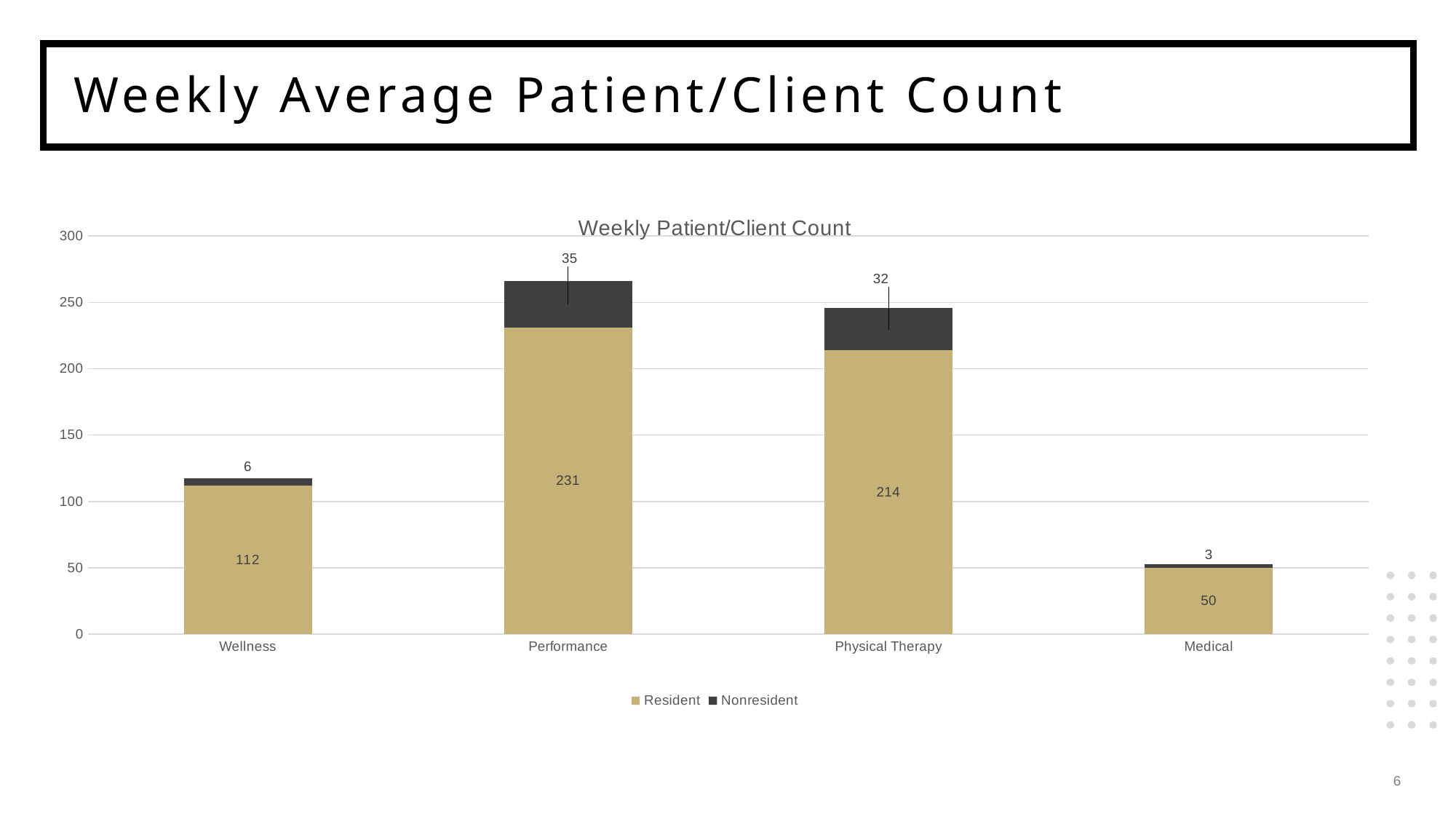
Which category has the highest Resident value? Performance What kind of chart is shown? Stacked bar chart Which category has the lowest Nonresident value? Medical What is the Nonresident value for Wellness? 6 What is the Nonresident value for Physical Therapy? 32 What is the total of the stacked bar for Physical Therapy? 246 How many series does the legend list? 2 What is the Resident value for Medical? 50 What is the difference between the Resident values for Performance and Physical Therapy? 17 How many categories are shown on the x axis? 4 What is the Resident value for Performance? 231 Which is larger, the Resident value for Wellness or the Resident value for Medical? Wellness